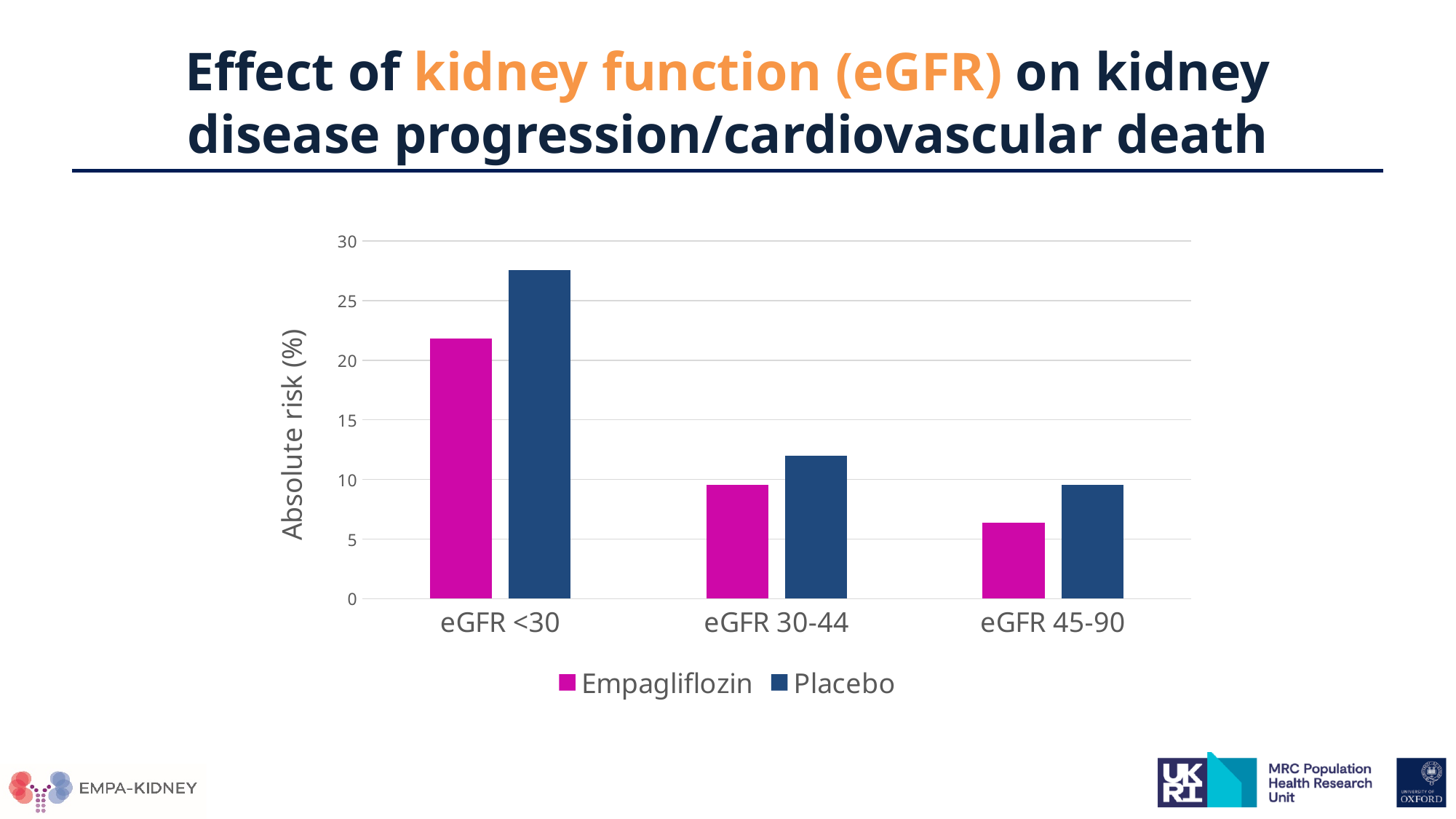
How many eGFR categories are shown on the x axis? 3 Do the Empagliflozin absolute risk values rise or fall moving from eGFR <30 to eGFR 45-90? fall How many series does the legend list? 2 Is the Empagliflozin absolute risk for eGFR <30 greater or less than 20? greater What is the label of the y axis? Absolute risk (%) Is the Placebo absolute risk for eGFR <30 greater or less than 25? greater Which eGFR category has the lowest Empagliflozin absolute risk? eGFR 45-90 Is the Empagliflozin absolute risk for eGFR 45-90 greater or less than 5? greater In the eGFR <30 group, which is larger: the Empagliflozin bar or the Placebo bar? Placebo What kind of chart is shown on the slide? bar chart Which eGFR category has the highest Placebo absolute risk? eGFR <30